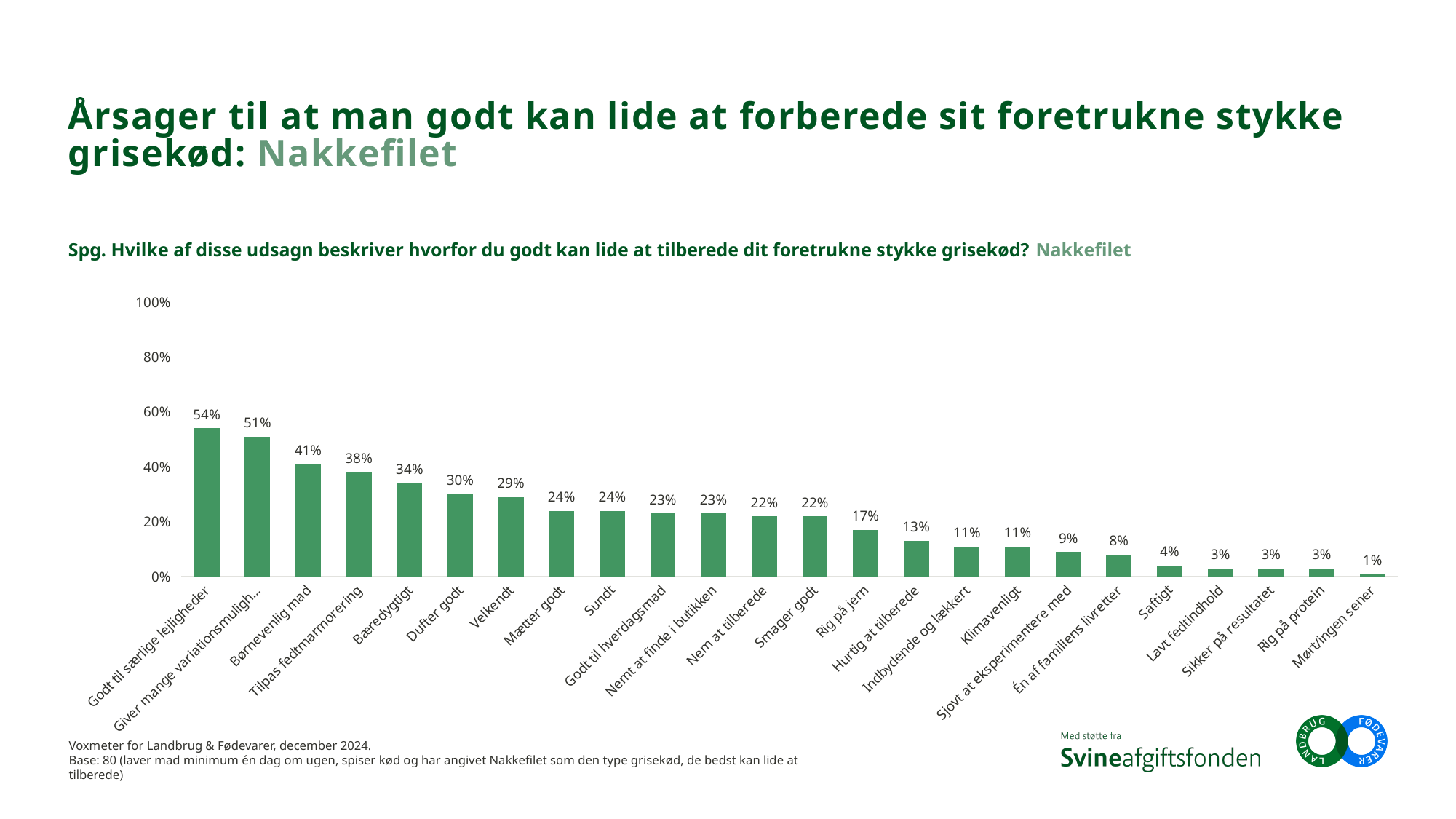
Do the values rise or fall from left to right along the x axis? Fall How many categories are shown in the chart? 24 Is the value for "Hurtig at tilberede" greater or less than 20%? less What kind of chart is shown on the slide? Bar chart What is the value for "Rig på jern"? 17% What is the difference between "Børnevenlig mad" and "Dufter godt"? 11 percentage points Which category has the highest value? Godt til særlige lejligheder What is the value for "Tilpas fedtmarmorering"? 38% What is the value for "Saftigt"? 4% Which category has the lowest value? Mørt/ingen sener Which is larger, "Bæredygtigt" or "Velkendt"? Bæredygtigt What percentage of respondents chose "Godt til særlige lejligheder"? 54%